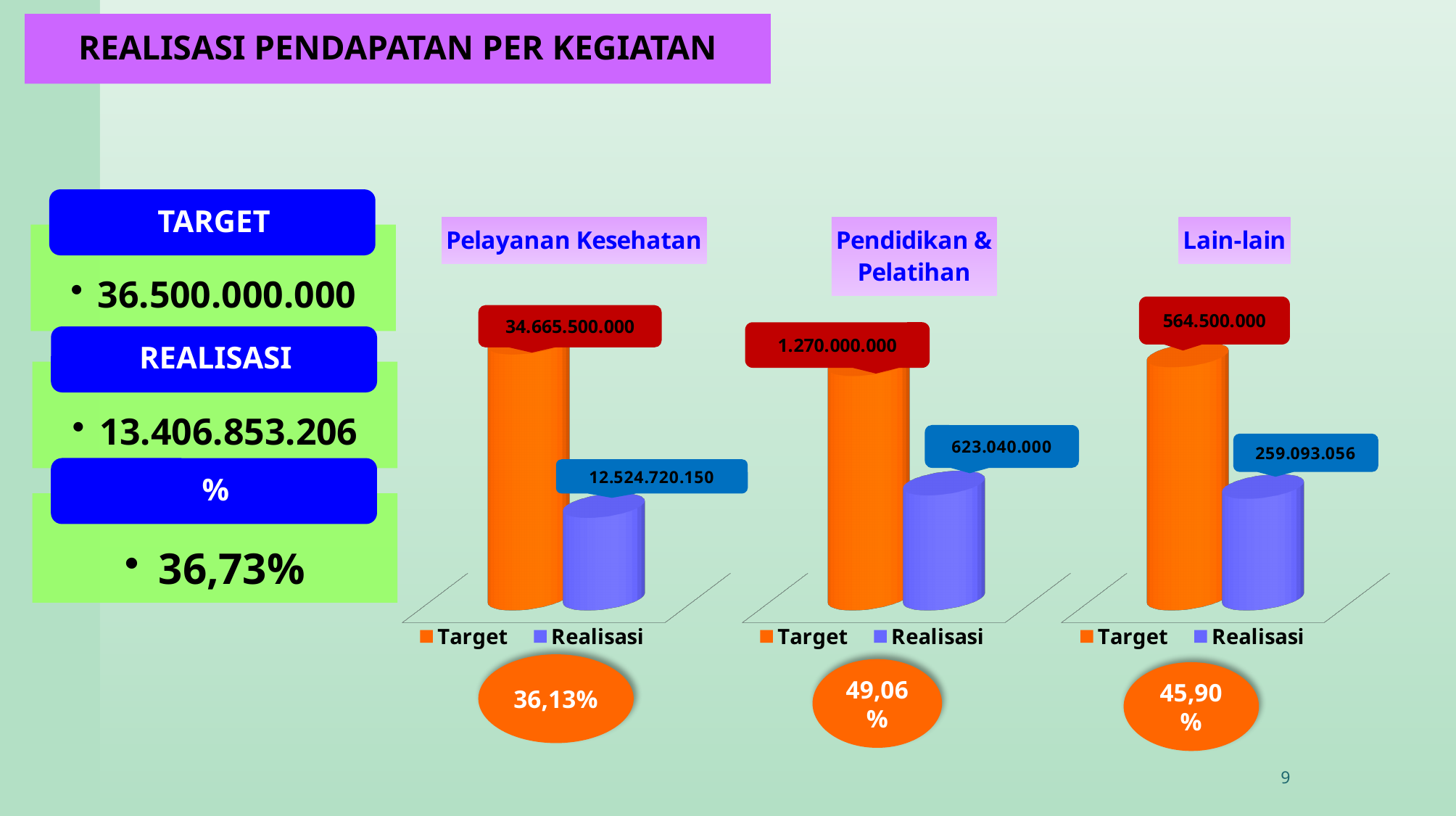
In the Lain-lain chart, what is the value of the Realisasi bar? 259.093.056 What kind of chart is the Pendidikan & Pelatihan chart? Bar chart In the Pendidikan & Pelatihan chart, what is the difference between the Target and Realisasi values? 646.960.000 In the Pelayanan Kesehatan chart, what colour is the Realisasi bar? Blue In the Pelayanan Kesehatan chart, what is the value of the Realisasi bar? 12.524.720.150 In the Pendidikan & Pelatihan chart, what is the value of the Realisasi bar? 623.040.000 In the Lain-lain chart, what is the value of the Target bar? 564.500.000 In the Pelayanan Kesehatan chart, which series has the larger value, Target or Realisasi? Target In the Pendidikan & Pelatihan chart, what is the value of the Target bar? 1.270.000.000 How many series does the legend of the Lain-lain chart list? 2 In the Lain-lain chart, what is the difference between the Target and Realisasi values? 305.406.944 In the Pelayanan Kesehatan chart, what is the value of the Target bar? 34.665.500.000